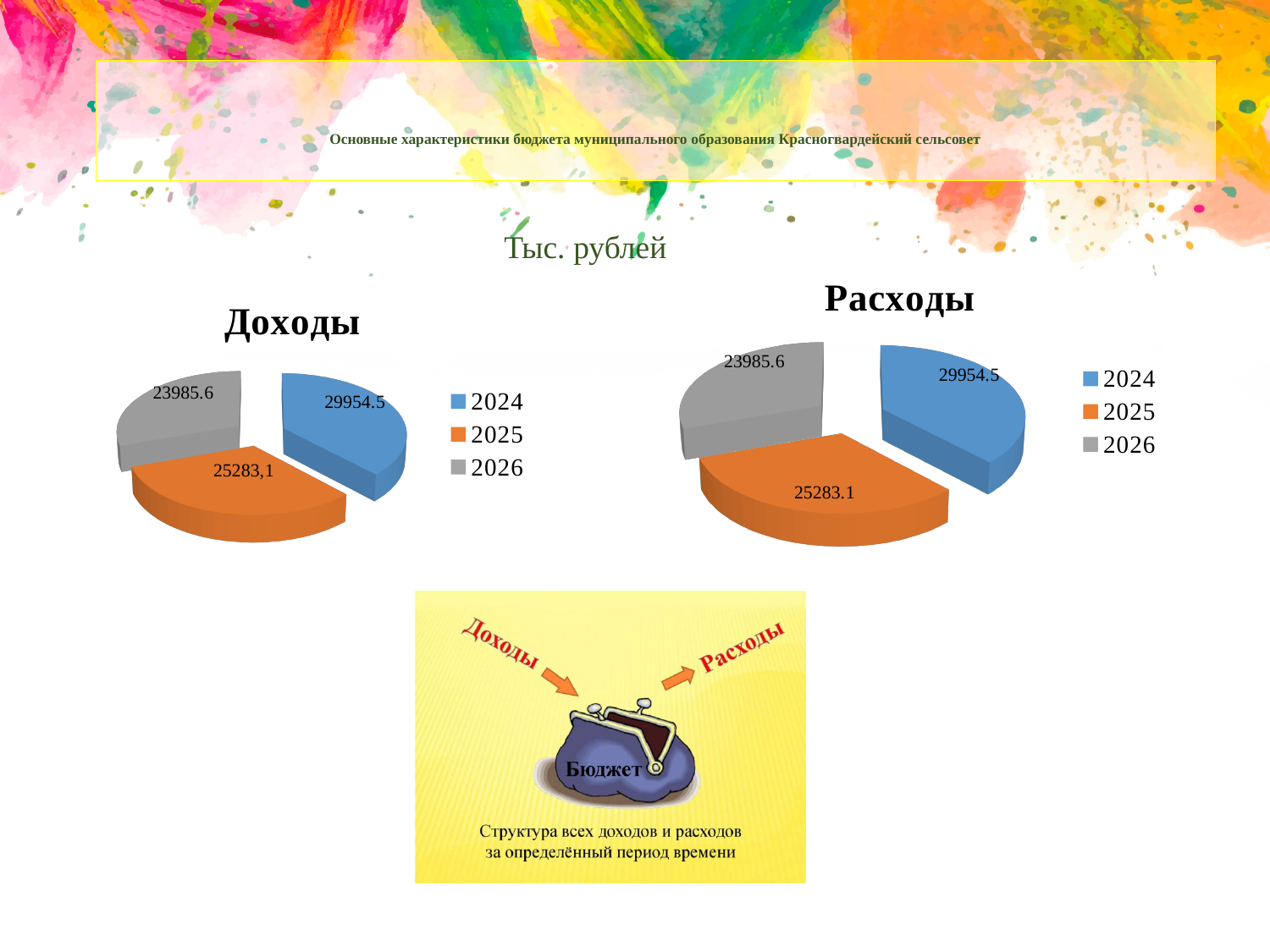
In the "Расходы" chart, what is the value for 2025? 25283.1 In the "Расходы" chart, what is the value for 2026? 23985.6 In the "Расходы" chart, which year has the largest slice? 2024 In the "Доходы" chart, what is the value for 2025? 25283,1 How many entries does the legend of the "Доходы" chart list? 3 In the "Доходы" chart, what is the value for 2024? 29954.5 In the "Доходы" chart, which year has the smallest slice? 2026 What type of chart is the "Доходы" chart? pie chart In the "Расходы" chart, what colour is the slice for 2026? grey How many slices does the "Расходы" pie chart have? 3 In the "Доходы" chart, which is larger, the value for 2025 or the value for 2026? 2025 In the "Расходы" chart, what is the difference between the values for 2024 and 2026? 5968.9